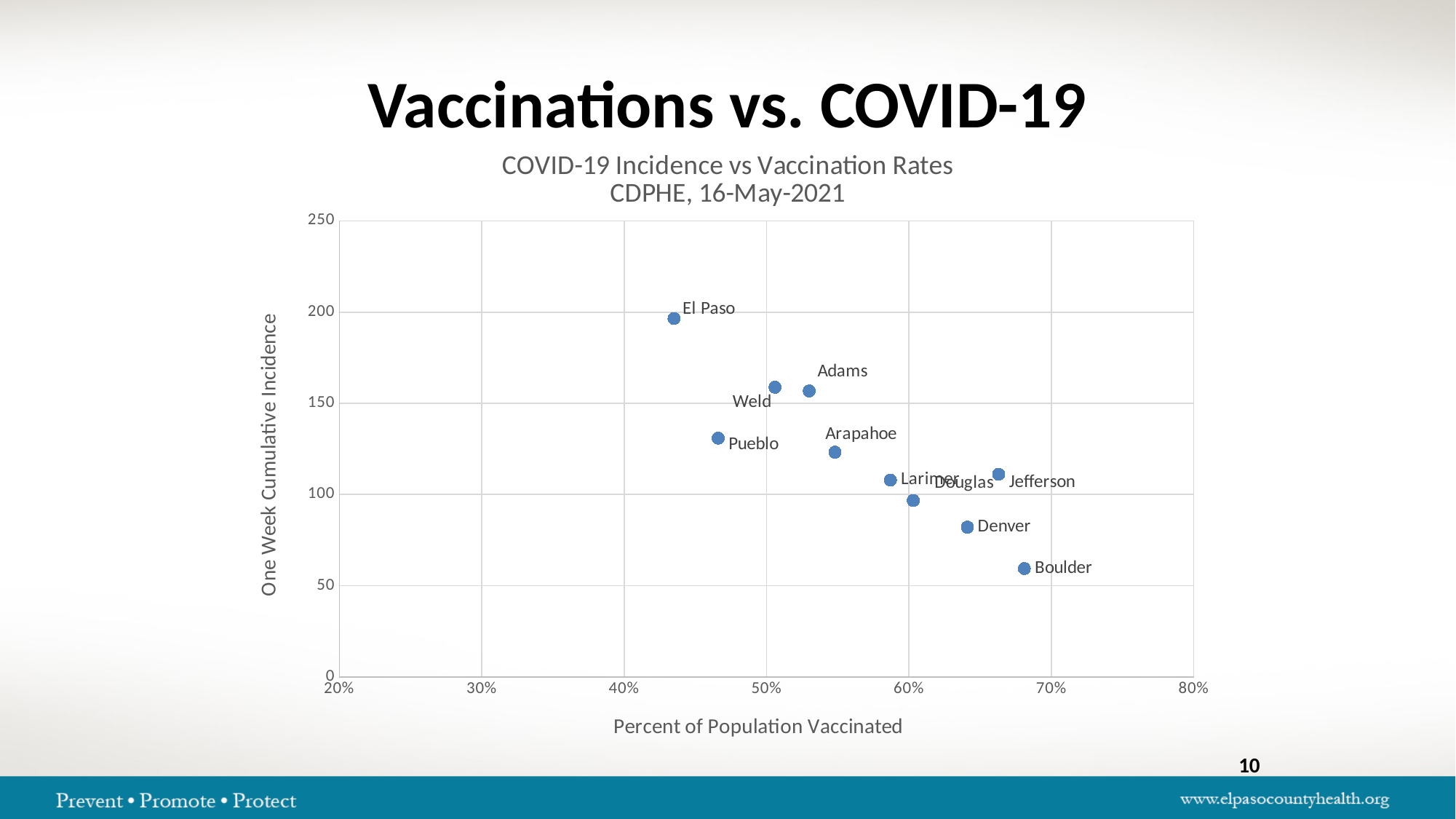
Is the one week cumulative incidence for Arapahoe greater or less than 150? less Is the one week cumulative incidence for El Paso greater or less than 150? greater Which county has the lowest percent of population vaccinated? El Paso Is the percent of population vaccinated for El Paso greater or less than 50%? less What kind of chart is shown on the slide? Scatter chart Which county has the lowest one week cumulative incidence? Boulder Which county has the highest one week cumulative incidence? El Paso As the percent of population vaccinated increases along the x axis, does the one week cumulative incidence generally rise or fall? fall Which county has a higher one week cumulative incidence, Pueblo or Denver? Pueblo What is the label of the x axis? Percent of Population Vaccinated How many counties are plotted on the chart? 10